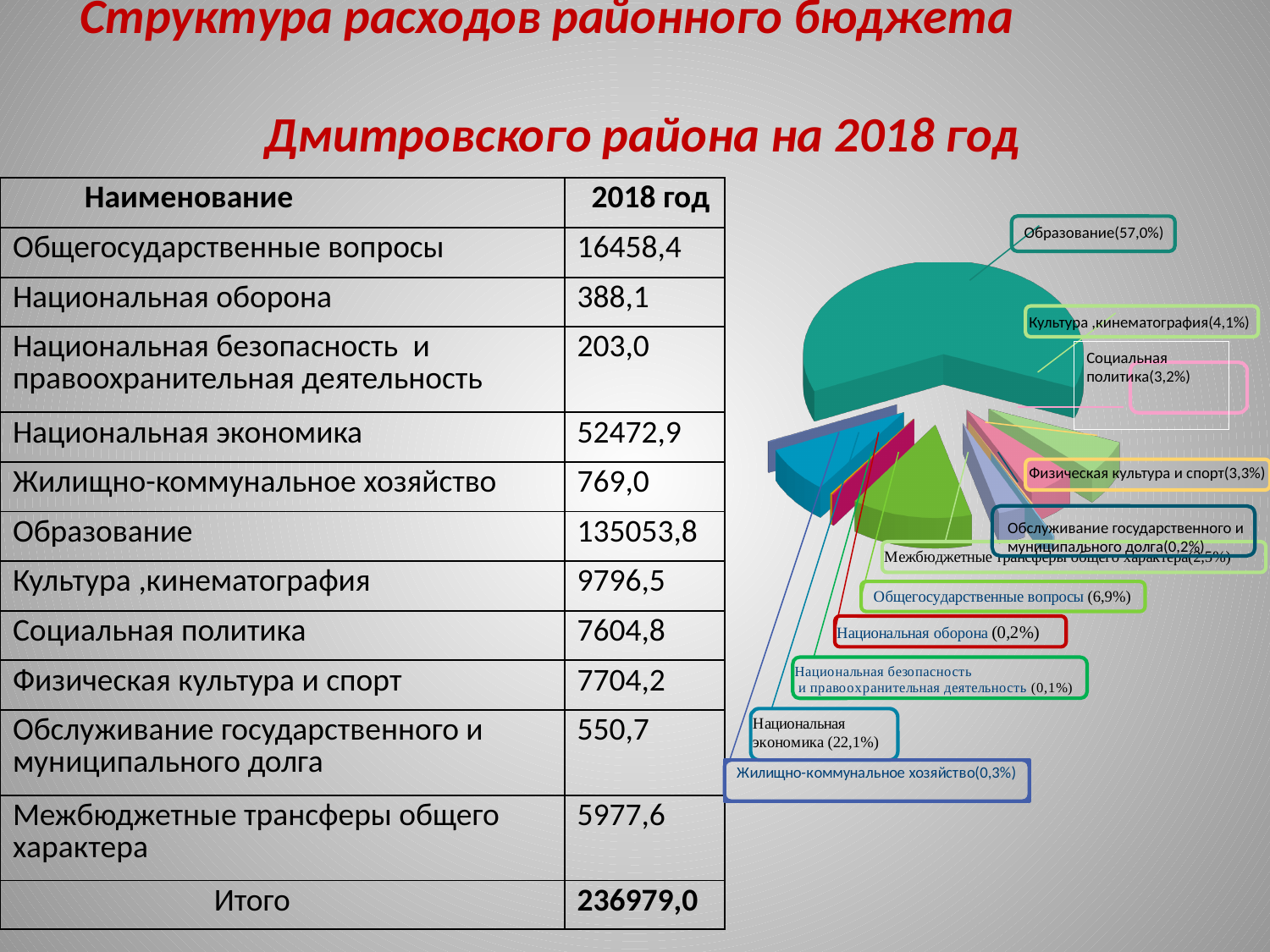
In the pie chart, which is larger: Национальная экономика or Общегосударственные вопросы? Национальная экономика By how many percentage points does the share of Образование exceed the share of Национальная экономика in the pie chart? 34,9% What share of the pie chart does Физическая культура и спорт account for? 3,3% What share of the pie chart does Жилищно-коммунальное хозяйство account for? 0,3% How many slices does the pie chart have? 11 What share of the pie chart does Национальная экономика account for? 22,1% Which category has the smallest slice in the pie chart? Национальная безопасность и правоохранительная деятельность Which category has the largest slice in the pie chart? Образование What kind of chart is shown on the slide? pie chart